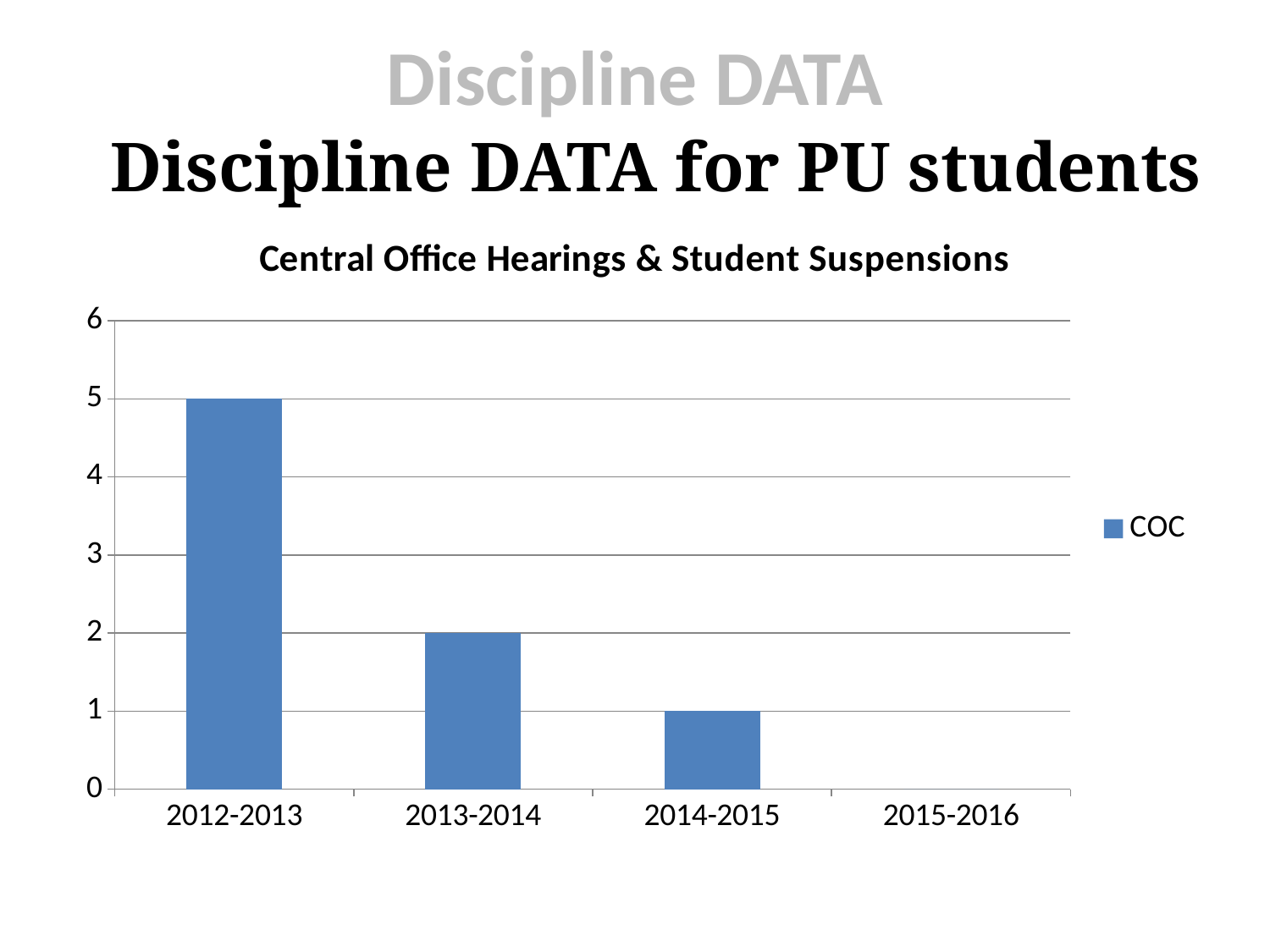
What is the COC value for 2012-2013? 5 What type of chart is shown on the slide? bar chart How many categories are shown on the x axis? 4 Which is larger, the COC value for 2013-2014 or for 2014-2015? 2013-2014 What is the title of the chart? Central Office Hearings & Student Suspensions What is the difference between the COC values for 2012-2013 and 2013-2014? 3 How many series does the legend list? 1 What is the COC value for 2013-2014? 2 Which year has the highest COC value? 2012-2013 What is the name of the series shown in the legend? COC Do the COC values rise or fall from 2012-2013 to 2015-2016? fall What is the COC value for 2014-2015? 1